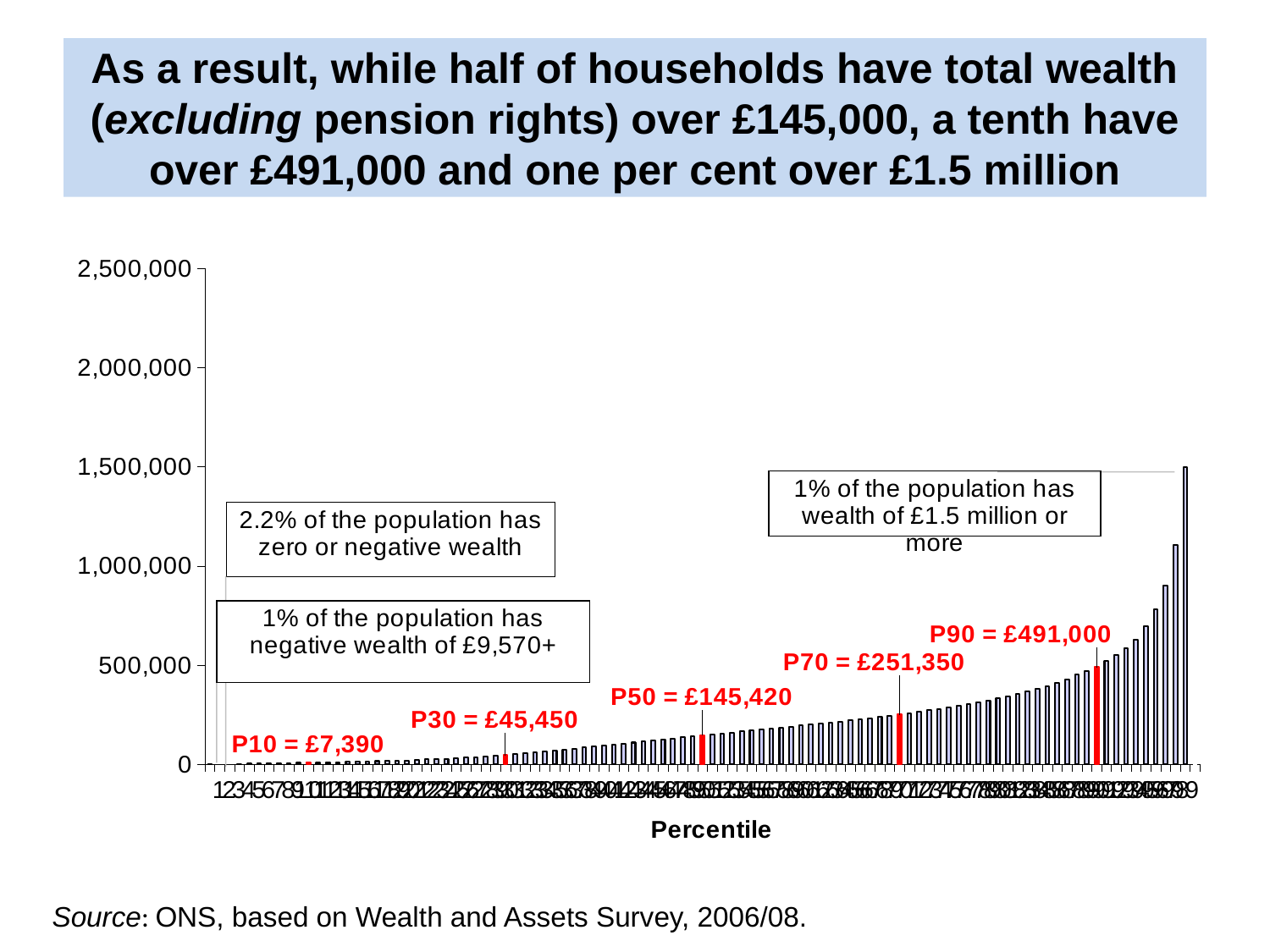
Is the value for the highest percentile bar at the right of the chart greater or less than 1,000,000? greater What is the difference between the labelled values for P50 and P30? £99,970 What is the value labelled for P70 on the chart? £251,350 What is the title of the x axis of the chart? Percentile Which is larger, the labelled value for P70 or for P50? P70 What is the value labelled for P90 on the chart? £491,000 Do the bar values rise or fall as the percentile increases along the x axis? rise What is the value labelled for P30 on the chart? £45,450 What is the difference between the labelled values for P90 and P70? £239,650 What kind of chart is shown on the slide? bar chart What is the value labelled for P50 on the chart? £145,420 What is the value labelled for P10 on the chart? £7,390